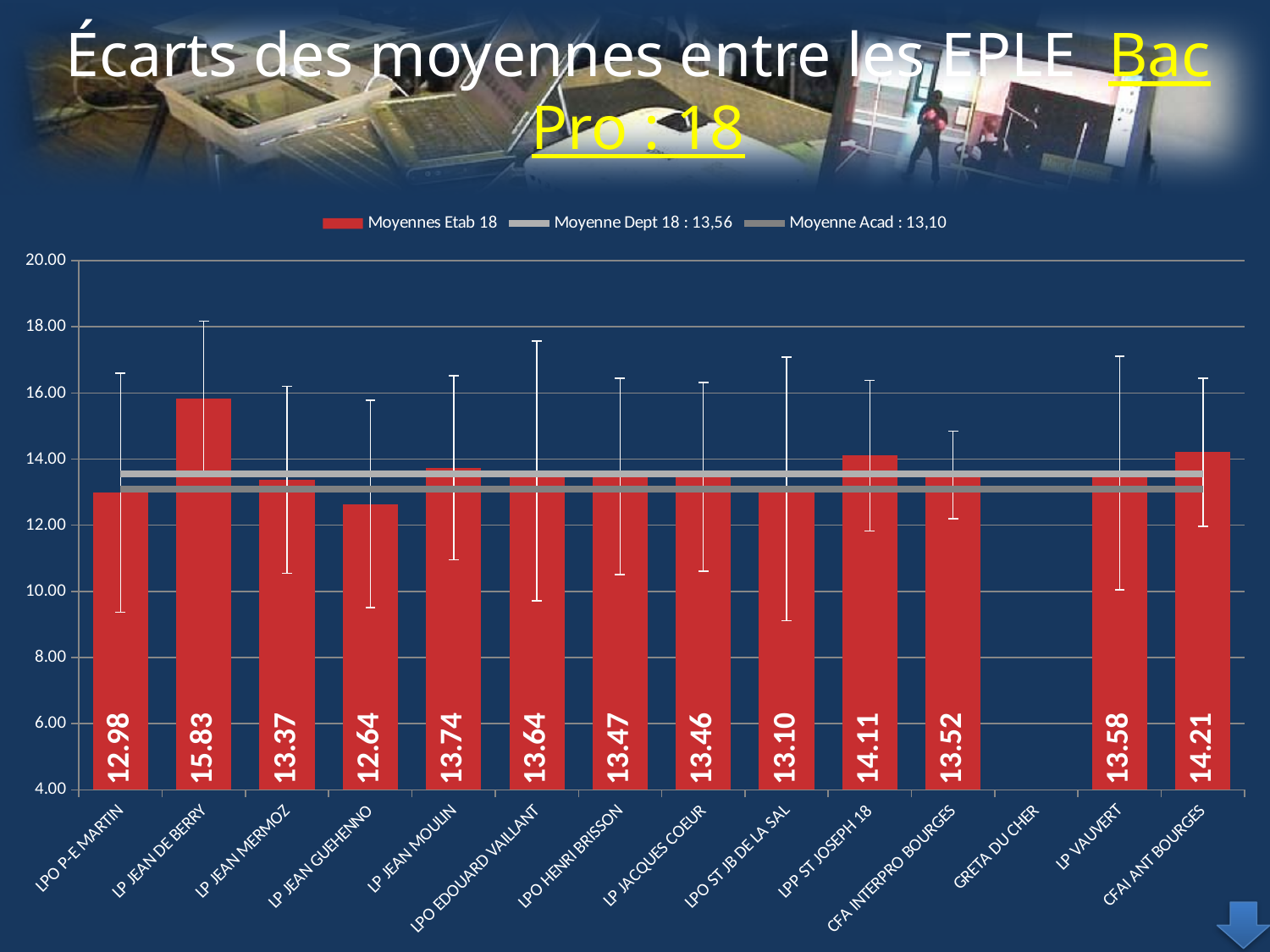
How many series does the legend list? 3 How many establishments are listed on the x axis? 14 Which establishment with a plotted bar has the lowest value? LP JEAN GUEHENNO What value does the legend give for Moyenne Dept 18? 13,56 What is the difference between the values for LP JEAN DE BERRY and LP JEAN GUEHENNO? 3.19 What is the value for LPO ST JB DE LA SAL? 13.10 Which establishment has the highest value? LP JEAN DE BERRY What is the value for LP JEAN DE BERRY? 15.83 What kind of chart is shown on the slide? Combination bar and line chart What is the value for CFAI ANT BOURGES? 14.21 Which is larger, the value for LPP ST JOSEPH 18 or the value for LP JEAN MOULIN? LPP ST JOSEPH 18 What is the value for LP JEAN GUEHENNO? 12.64